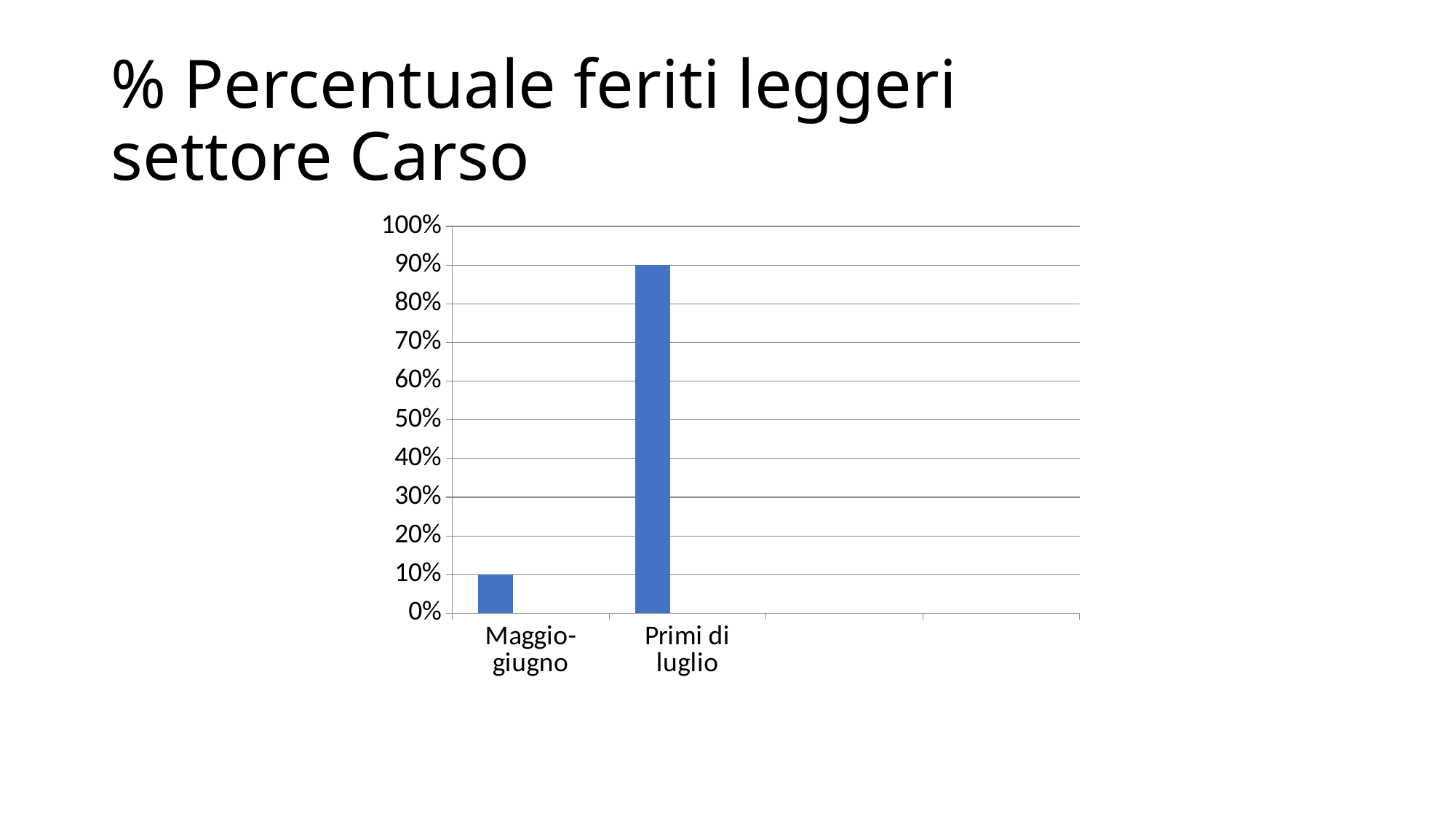
Which category has the lowest value? Maggio-giugno What kind of chart is shown on the slide? bar chart What is the title of the slide? % Percentuale feriti leggeri settore Carso What is the difference between the values for Primi di luglio and Maggio-giugno? 80% How many categories are shown on the x axis? 2 Is the value for Maggio-giugno greater or less than 20%? less Is the value for Primi di luglio greater or less than 50%? greater Which is larger, the value for Maggio-giugno or the value for Primi di luglio? Primi di luglio Do the values rise or fall from Maggio-giugno to Primi di luglio? rise What is the value for Maggio-giugno? 10% What is the value for Primi di luglio? 90% Which category has the highest value? Primi di luglio